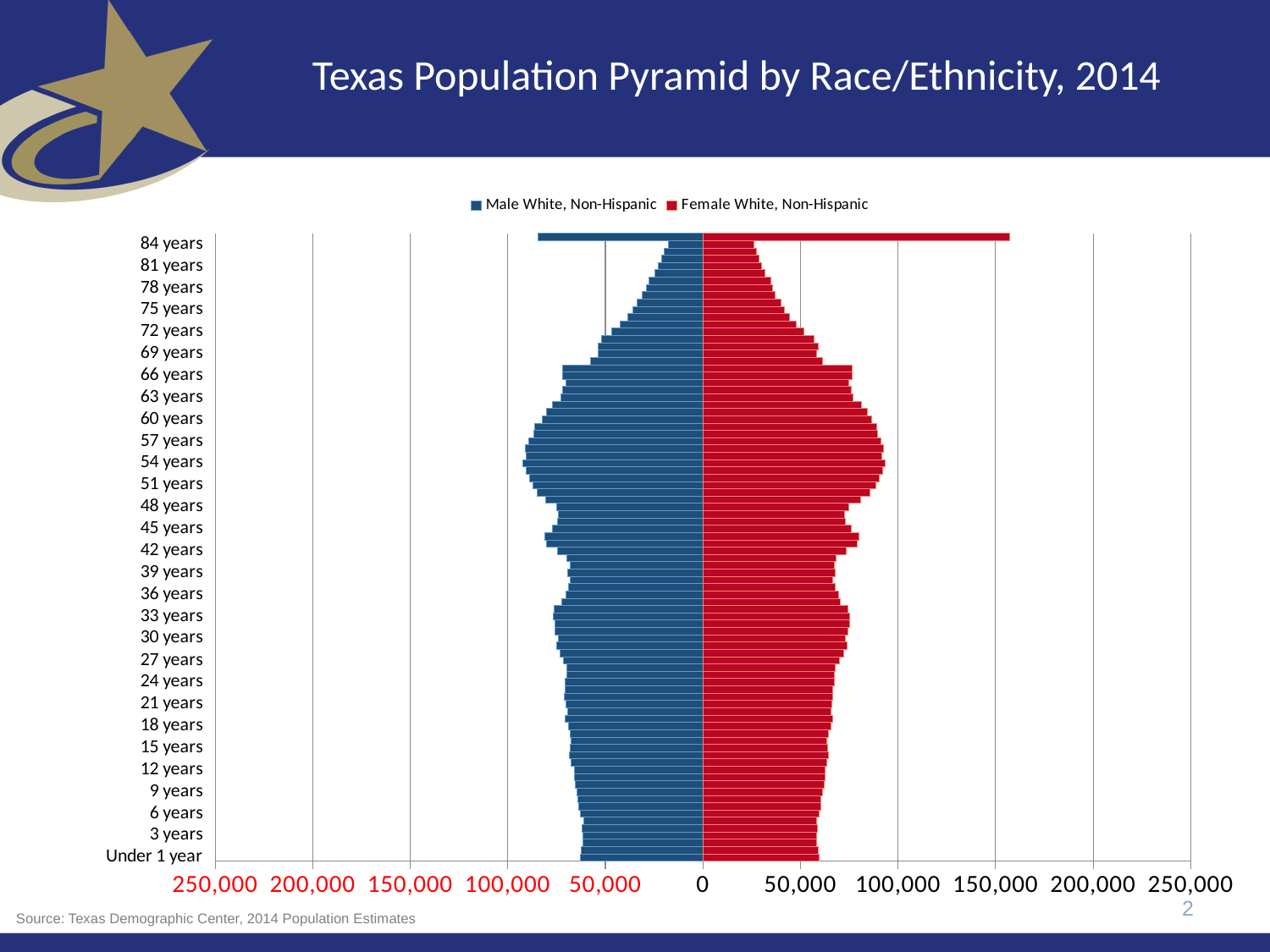
What kind of chart is shown on the slide? Bar chart Is the value for Male White, Non-Hispanic at 60 years greater or less than 50,000? greater Which series is shown in red? Female White, Non-Hispanic Is the value for Female White, Non-Hispanic at 84 years greater or less than 100,000? less Is the value for Female White, Non-Hispanic at Under 1 year greater or less than 100,000? less What is the title of the chart? Texas Population Pyramid by Race/Ethnicity, 2014 At 84 years, which is larger: the Male White, Non-Hispanic bar or the Female White, Non-Hispanic bar? Female White, Non-Hispanic Do the Female White, Non-Hispanic bars get longer or shorter going from 54 years up to 81 years? shorter How many series does the legend list? 2